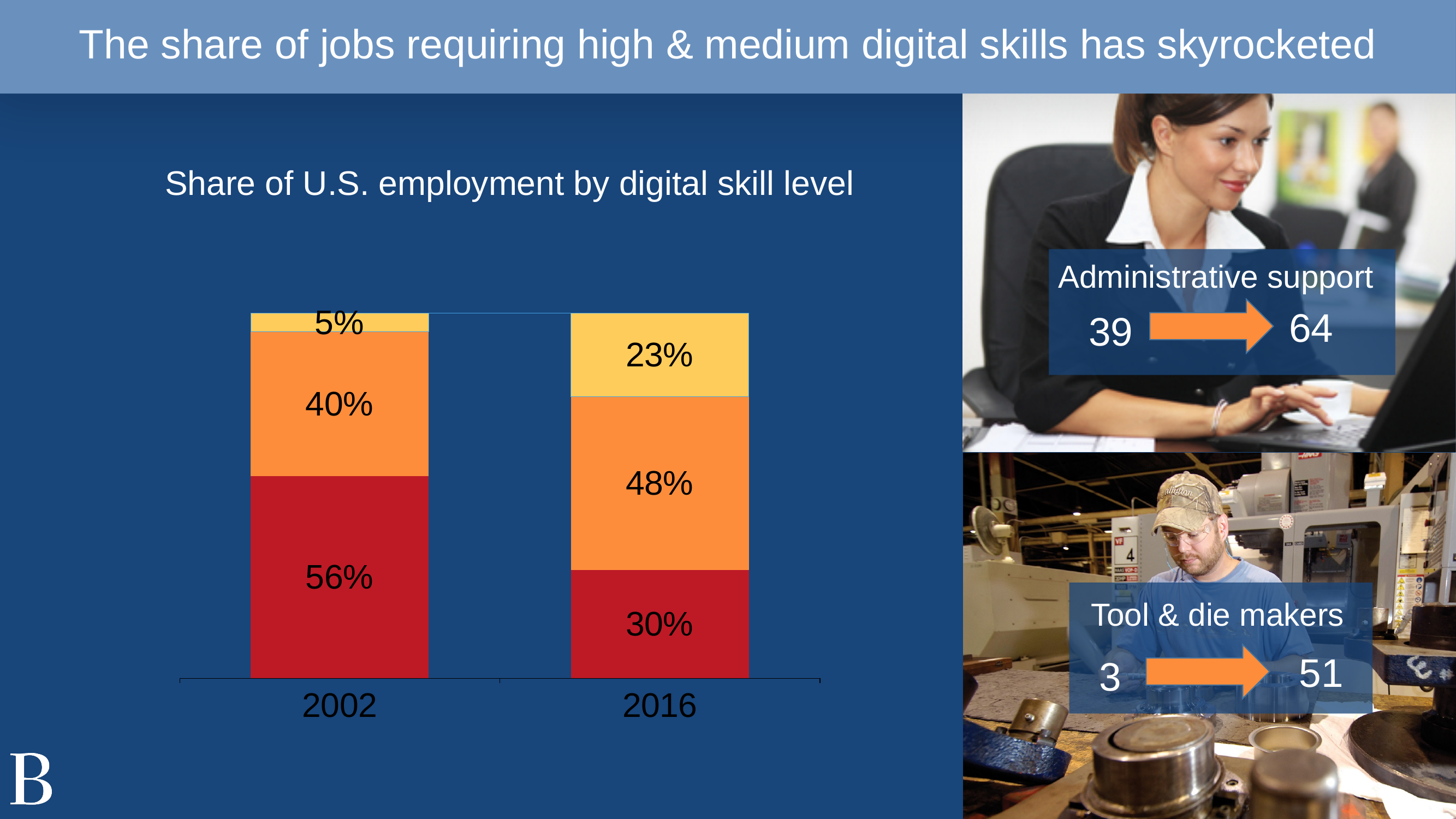
What is the value of the yellow (top) segment for 2002? 5% What is the title of the chart? Share of U.S. employment by digital skill level What is the value of the orange (middle) segment for 2016? 48% How many categories (years) are shown on the x axis of the chart? 2 By how many percentage points did the yellow (top) segment grow from 2002 to 2016? 18 What is the value of the yellow (top) segment for 2016? 23% What kind of chart is shown on the slide? Stacked bar chart What is the value of the red (bottom) segment for 2002? 56% What is the value of the red (bottom) segment for 2016? 30% Which year has the larger orange (middle) segment, 2002 or 2016? 2016 By how many percentage points did the red (bottom) segment fall from 2002 to 2016? 26 Does the red (bottom) segment rise or fall from 2002 to 2016? Fall